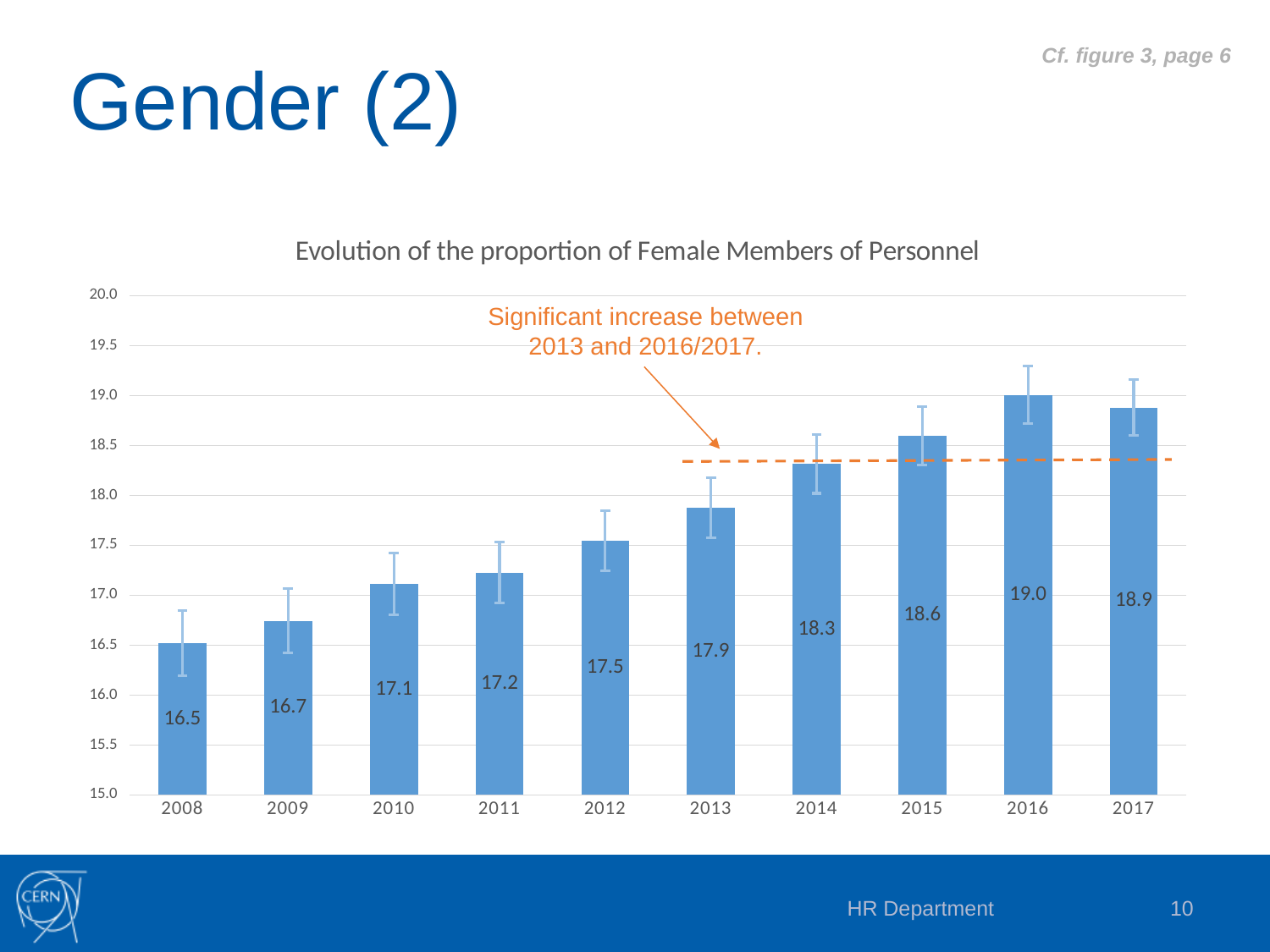
Which year has the lowest value? 2008 What is the value for 2008? 16.5 What is the value for 2013? 17.9 Which year has the highest value? 2016 What is the title of the chart? Evolution of the proportion of Female Members of Personnel How many years are shown on the x axis? 10 Is the value for 2011 greater or less than 17.5? less What is the value for 2016? 19.0 What is the difference between the values for 2014 and 2013? 0.4 Which is larger, the value for 2012 or the value for 2015? 2015 What kind of chart is this? bar chart What is the difference between the values for 2016 and 2008? 2.5